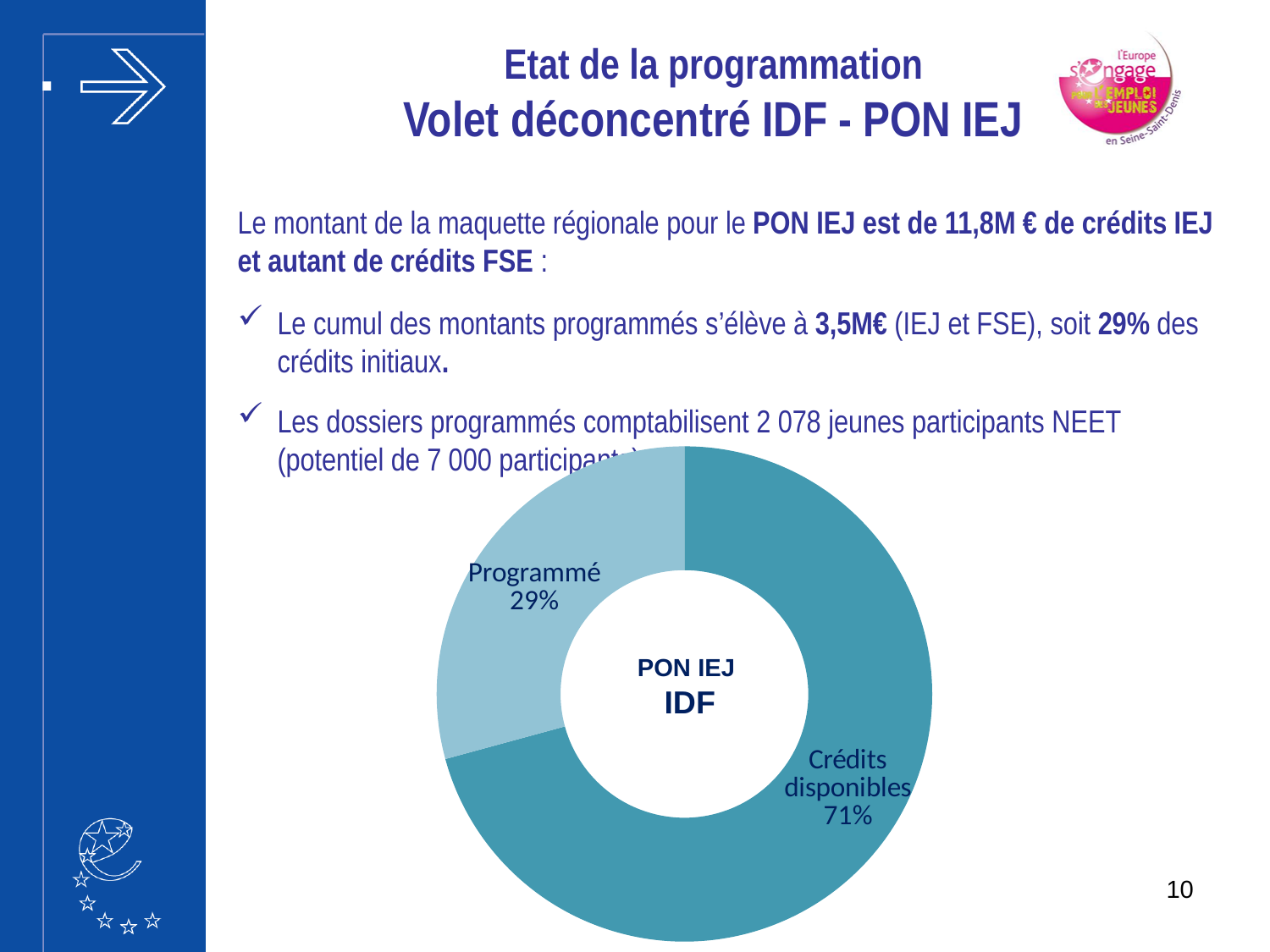
What is the difference in percentage points between the 'Crédits disponibles' slice and the 'Programmé' slice? 42 Which slice of the pie chart is the largest? Crédits disponibles Is the share of the 'Programmé' slice greater or less than 50%? less What share of the pie chart does the 'Crédits disponibles' slice represent? 71% What kind of chart is shown on the slide? Pie chart (doughnut) How many slices does the pie chart have? 2 Which slice of the pie chart is the smallest? Programmé What text is written in the centre of the doughnut chart? PON IEJ IDF Which is larger in the pie chart, 'Programmé' or 'Crédits disponibles'? Crédits disponibles What share of the pie chart does the 'Programmé' slice represent? 29%